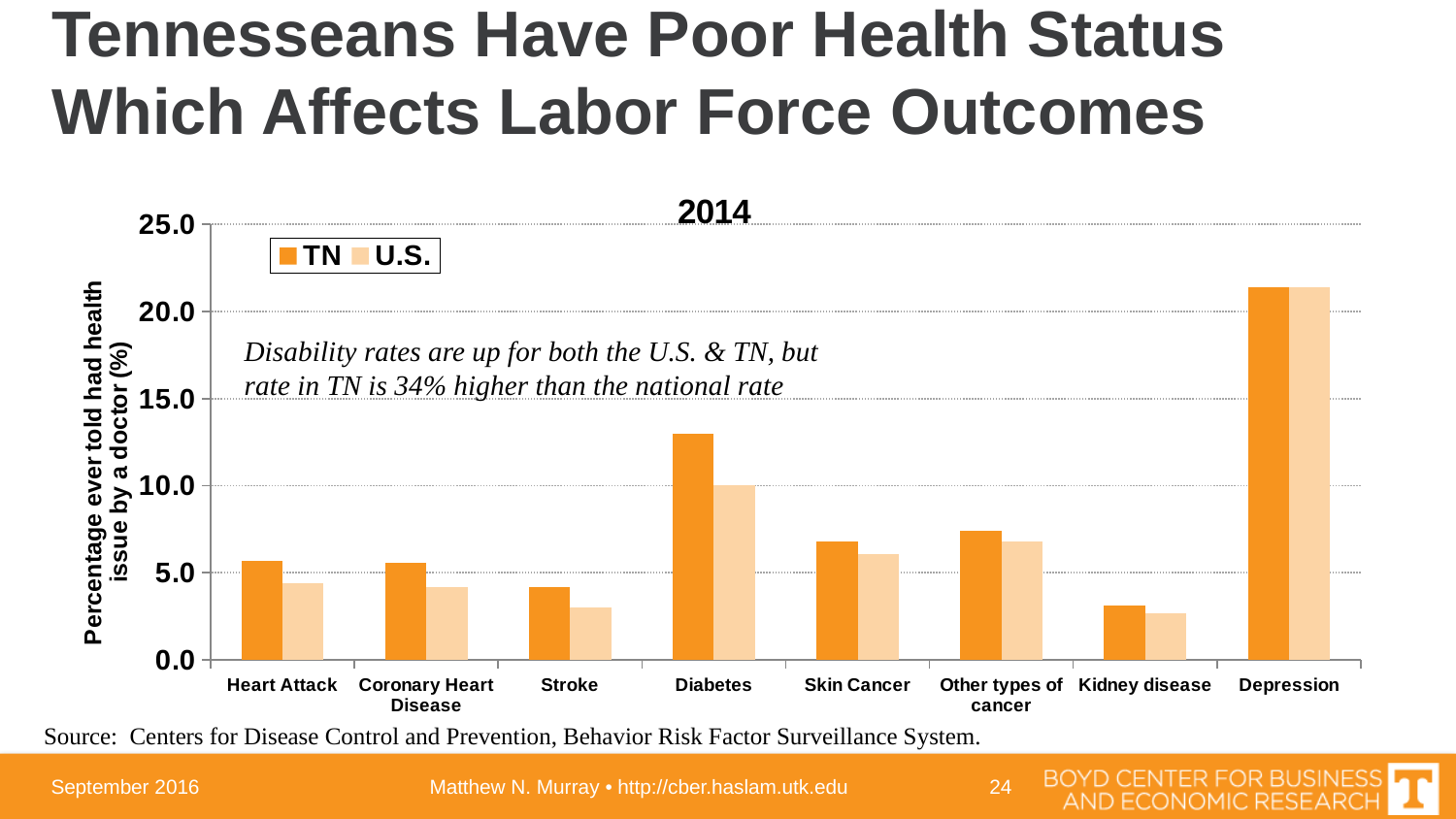
Is the TN value for Depression greater or less than 20.0? greater How many health conditions are shown along the x axis of the chart? 8 What kind of chart is shown on the slide? bar chart What is the title shown above the chart? 2014 Is the TN value for Diabetes greater or less than 10.0? greater Is the U.S. value for Stroke greater or less than 5.0? less For Diabetes, which is larger: the TN value or the U.S. value? TN How many series does the chart legend list? 2 Which health condition has the highest TN percentage in the chart? Depression What are the two entries in the chart legend? TN and U.S. Which health condition has the lowest U.S. percentage in the chart? Kidney disease